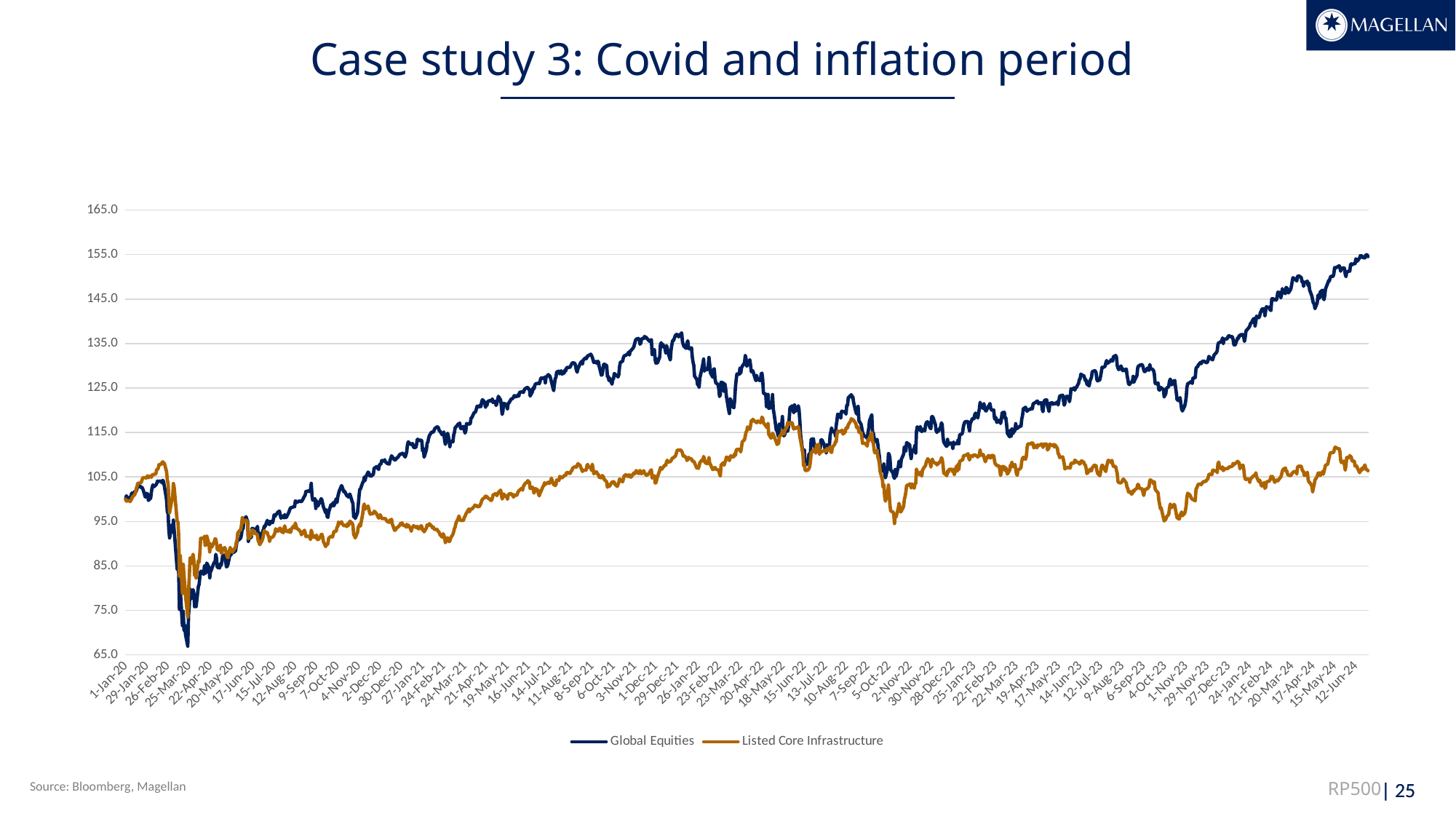
Overall, does the Global Equities line rise or fall from 1-Jan-20 to 12-Jun-24? Rise What are the two series named in the legend? Global Equities and Listed Core Infrastructure Which series has the higher value at 12-Jun-24, Global Equities or Listed Core Infrastructure? Global Equities Is the value for Listed Core Infrastructure at 12-Jun-24 greater or less than 115? less Which series reaches the highest value anywhere on the chart? Global Equities How many series does the legend list? 2 Is the value for Global Equities at 12-Jun-24 greater or less than 145? greater Is the lowest value reached by Global Equities in March 2020 greater or less than 75? less What colour is the Global Equities line? Dark blue Which series has the higher value at the March 2020 low point, Global Equities or Listed Core Infrastructure? Listed Core Infrastructure What kind of chart is shown on the slide? Line chart